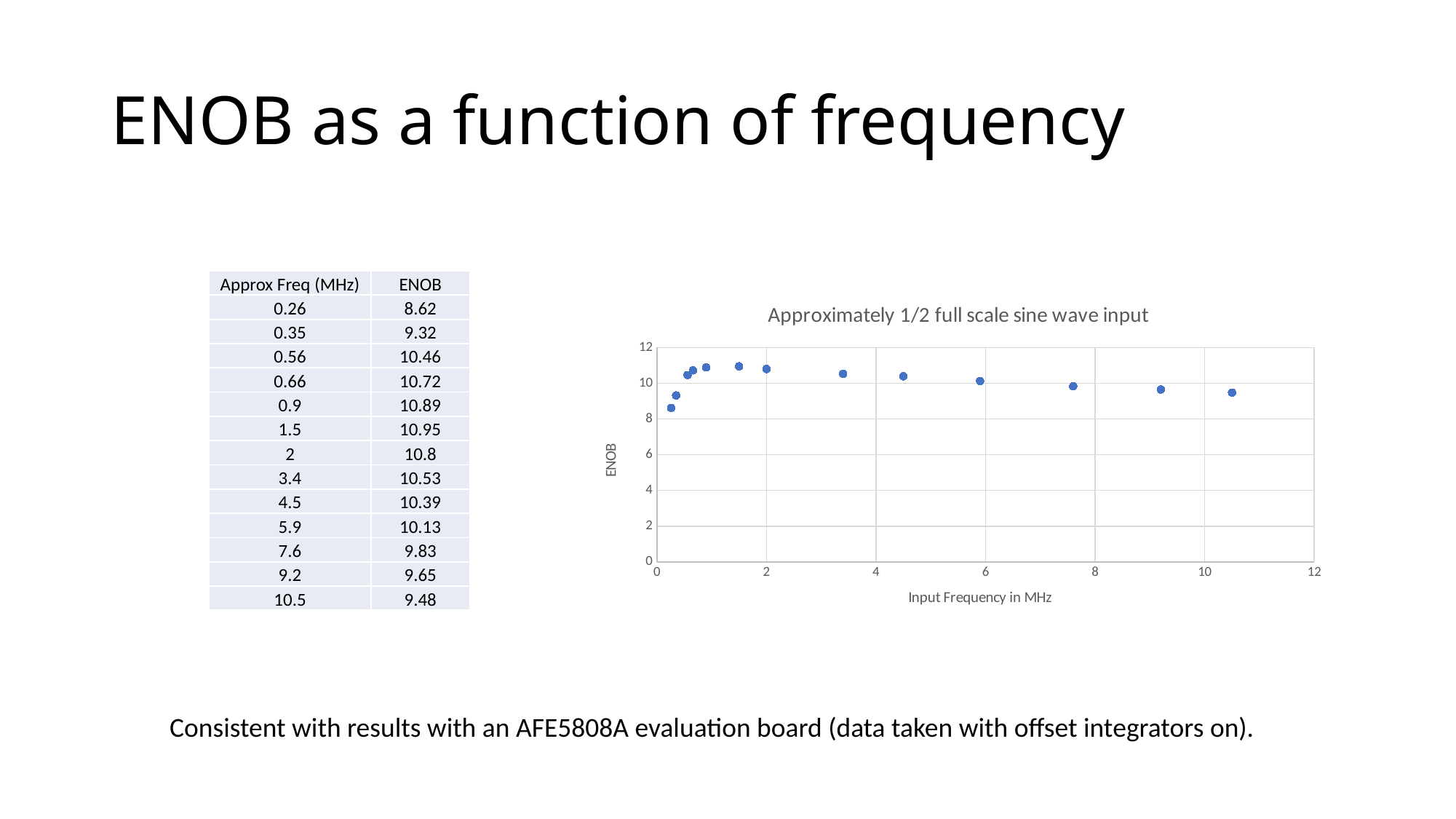
What kind of chart is shown on the slide? scatter chart What is the label of the x axis of the chart? Input Frequency in MHz At which approximate frequency in the table is the ENOB highest? 1.5 MHz According to the table, what is the ENOB at an approximate frequency of 0.26 MHz? 8.62 Which is larger, the ENOB at 2 MHz or the ENOB at 7.6 MHz? 2 MHz Is the ENOB value plotted at 10.5 MHz greater or less than 10? less At which approximate frequency in the table is the ENOB lowest? 0.26 MHz According to the table, what is the ENOB at an approximate frequency of 4.5 MHz? 10.39 What is the difference between the ENOB at 0.9 MHz and the ENOB at 9.2 MHz, using the table values? 1.24 According to the table, what is the ENOB at an approximate frequency of 10.5 MHz? 9.48 How many data points are plotted in the chart? 13 What is the title of the chart? Approximately 1/2 full scale sine wave input